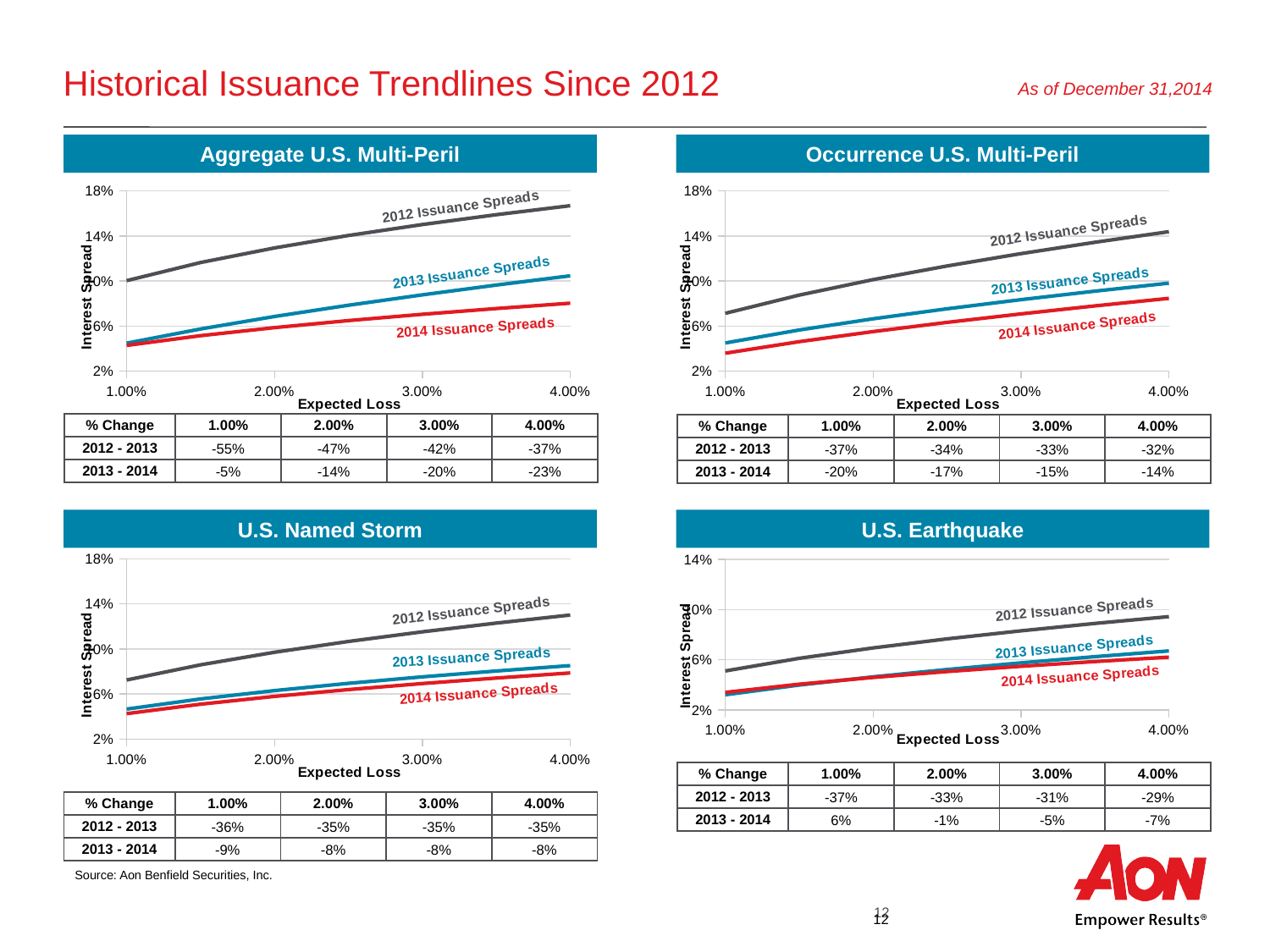
In the Aggregate U.S. Multi-Peril chart, which series has the highest values? 2012 Issuance Spreads In the Aggregate U.S. Multi-Peril chart, is the 2012 Issuance Spreads value at 4.00% Expected Loss greater or less than 14%? greater What is the x-axis title of the U.S. Named Storm chart? Expected Loss In the U.S. Named Storm chart, does the 2012 Issuance Spreads line rise or fall as Expected Loss increases? rise How many series are plotted in the Occurrence U.S. Multi-Peril chart? 3 In the Occurrence U.S. Multi-Peril chart, which series has the lowest values? 2014 Issuance Spreads What type of chart is the Aggregate U.S. Multi-Peril chart? line chart In the U.S. Earthquake chart, which is higher at 4.00% Expected Loss: 2012 Issuance Spreads or 2014 Issuance Spreads? 2012 Issuance Spreads In the U.S. Named Storm chart, is the 2012 Issuance Spreads value at 4.00% Expected Loss greater or less than 10%? greater What is the y-axis title of the U.S. Earthquake chart? Interest Spread How many Expected Loss tick values are shown on the x-axis of the Aggregate U.S. Multi-Peril chart? 4 In the Occurrence U.S. Multi-Peril chart, is the 2014 Issuance Spreads value at 1.00% Expected Loss greater or less than 6%? less